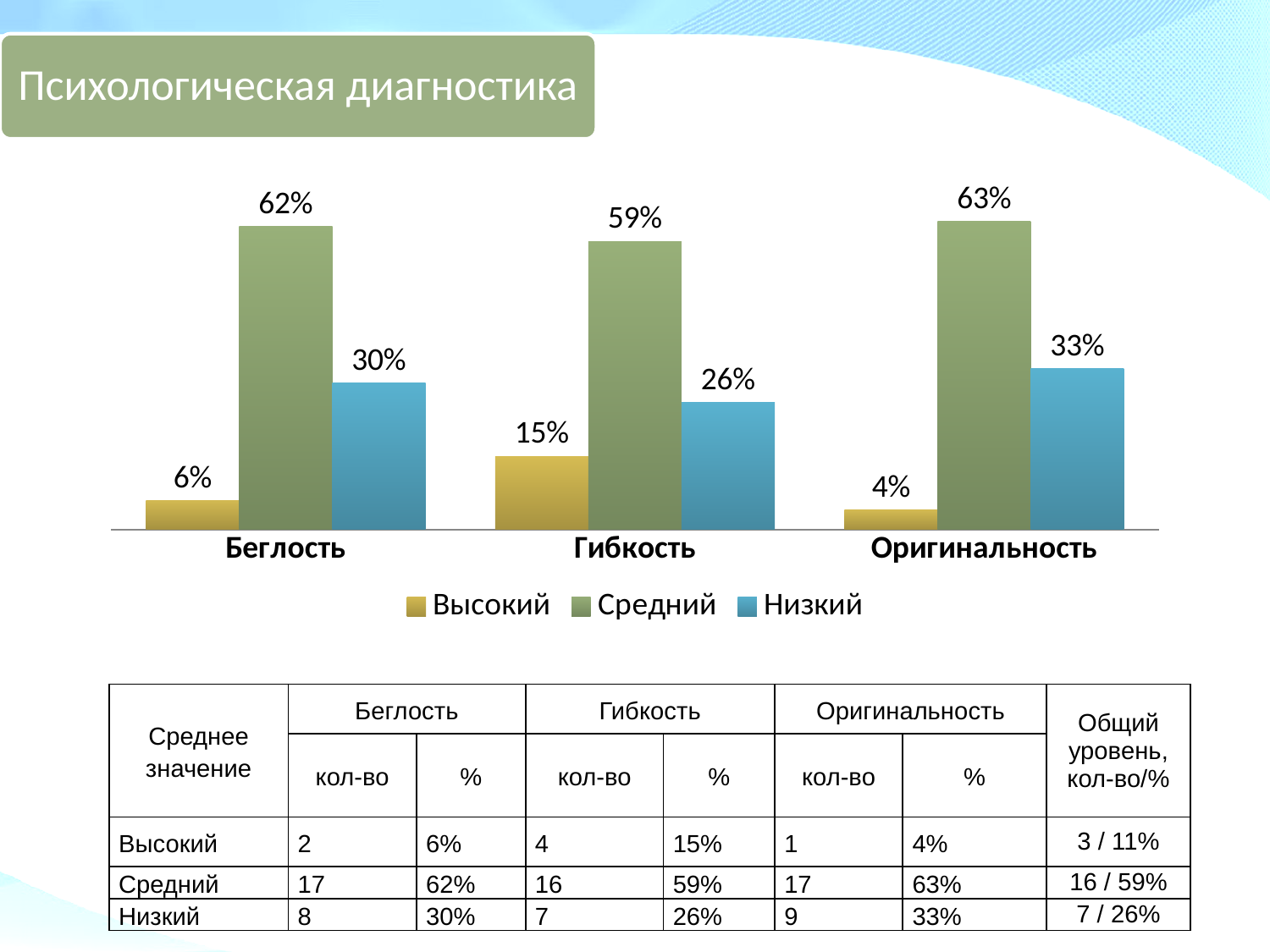
What kind of chart is shown on the slide? Bar chart What is the value for Низкий in the Оригинальность category? 33% What is the difference between the Высокий values for Гибкость and Беглость? 9% Which category has the highest value for the Средний series? Оригинальность What is the difference between the Средний and Низкий values in the Гибкость category? 33% What is the value for Средний in the Беглость category? 62% How many categories are shown on the x axis of the chart? 3 How many series does the legend list? 3 What is the value for Высокий in the Гибкость category? 15% Which series is shown in blue in the chart? Низкий Which is larger: the Низкий value for Беглость or the Низкий value for Гибкость? Беглость Which category has the lowest value for the Высокий series? Оригинальность